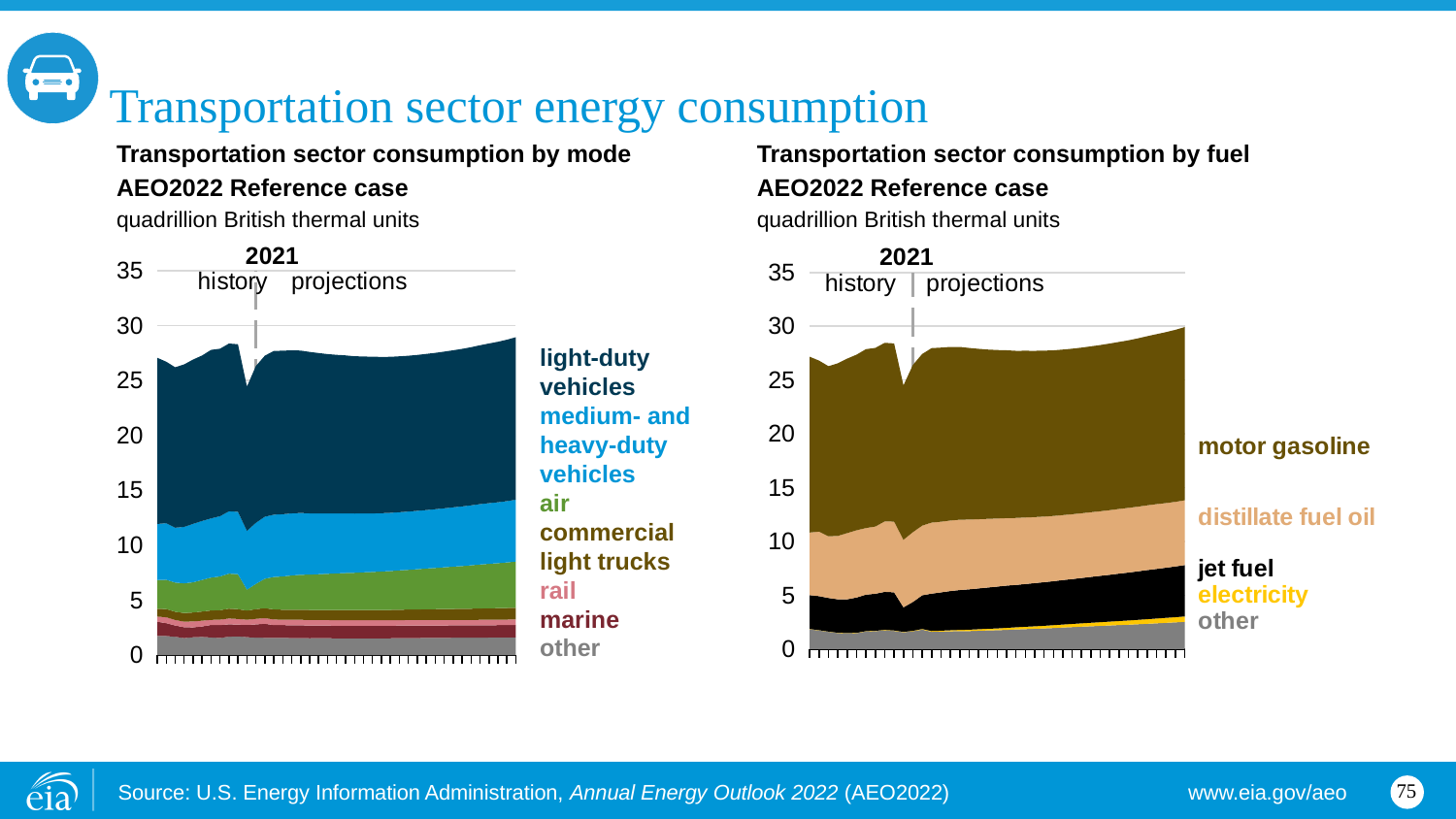
In the 'Transportation sector consumption by mode' chart, which mode accounts for the largest share of consumption? light-duty vehicles What kind of chart is the 'Transportation sector consumption by mode' chart on the left? stacked area chart In the 'Transportation sector consumption by fuel' chart, which fuel accounts for the largest share of consumption? motor gasoline In the 'Transportation sector consumption by fuel' chart, which fuel accounts for the smallest share of consumption? electricity In the 'Transportation sector consumption by fuel' chart, which is larger: motor gasoline or jet fuel? motor gasoline How many series does the legend of the 'Transportation sector consumption by mode' chart list? 7 What unit is used on the y axis of the 'Transportation sector consumption by fuel' chart? quadrillion British thermal units In the 'Transportation sector consumption by fuel' chart, is the total consumption at the start of the history period greater or less than 25? greater In the 'Transportation sector consumption by mode' chart, does total consumption rise or fall over the projection period? rise What year separates history from projections in both charts? 2021 In the 'Transportation sector consumption by mode' chart, is the total consumption at the end of the projection period greater or less than 30? less How many series does the legend of the 'Transportation sector consumption by fuel' chart list? 5